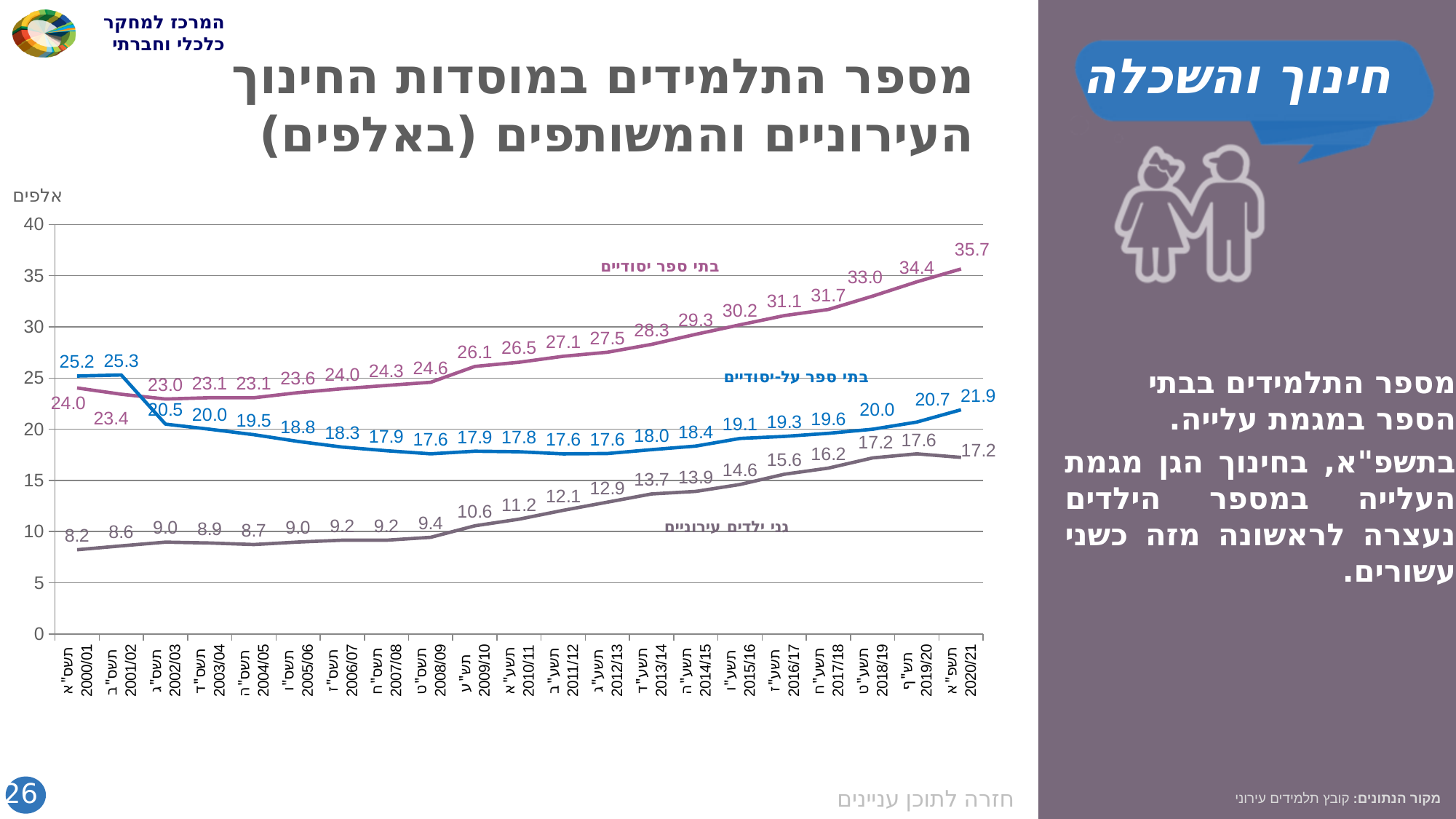
Which series has the larger value in תש"ס 2000/01: בתי ספר יסודיים or בתי ספר על-יסודיים? בתי ספר על-יסודיים In which school year does the בתי ספר יסודיים series reach its highest value? תשפ"א 2020/21 What type of chart is shown on the slide? line chart What is the value for בתי ספר יסודיים in תשפ"א 2020/21? 35.7 What unit label is shown above the y axis? אלפים What is the difference between the בתי ספר יסודיים value in תשפ"א 2020/21 and in תש"ס 2000/01? 11.7 How many school years are shown along the x axis? 21 What is the value for גני ילדים עירוניים in תשע"ט 2018/19? 17.2 What is the value for בתי ספר על-יסודיים in תש"ס 2000/01? 25.2 How many data series (lines) are plotted on the chart? 3 Does the גני ילדים עירוניים series generally rise or fall from 2000/01 to 2020/21? rise